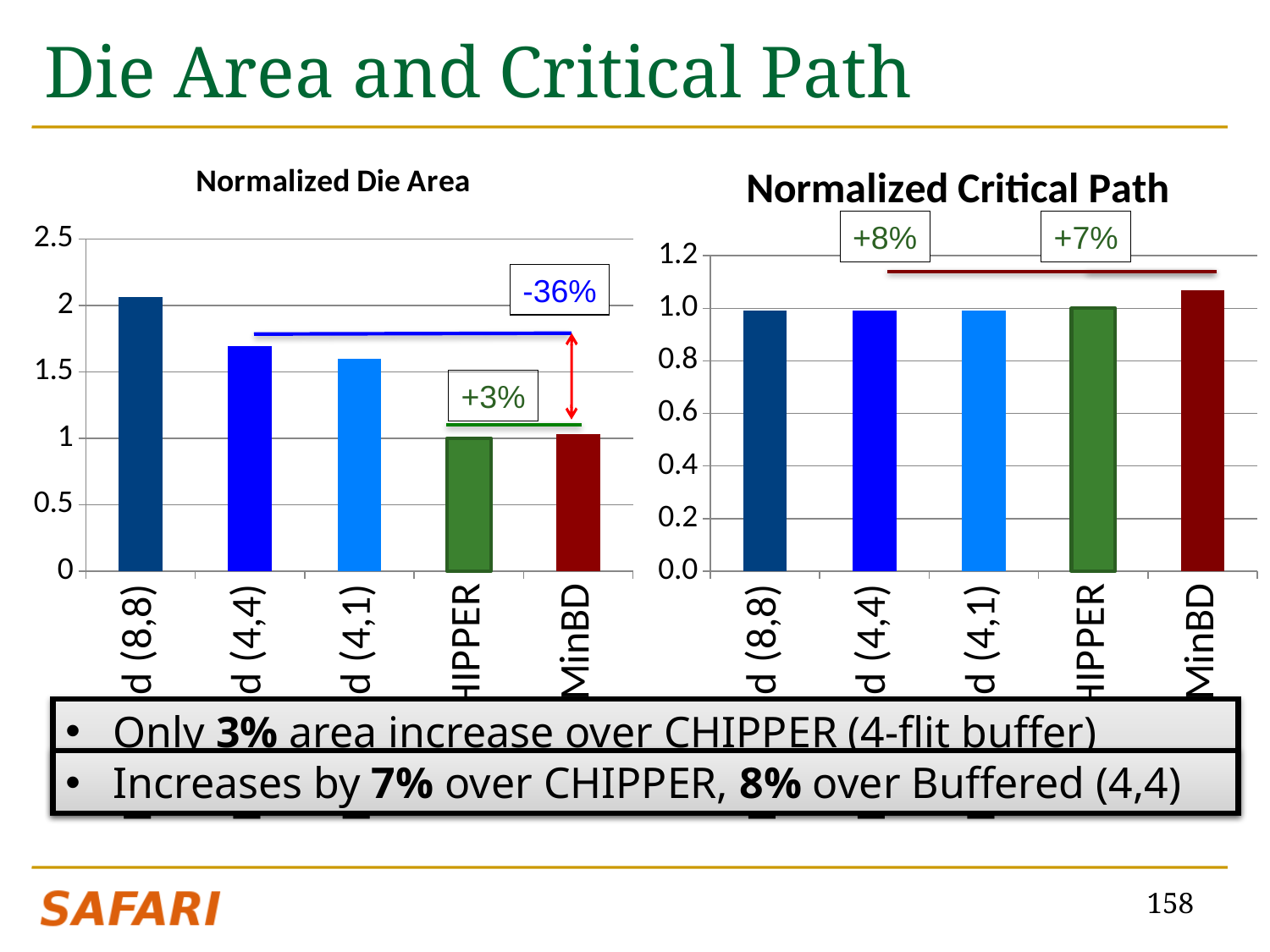
How many bars does the Normalized Critical Path chart show? 5 In the Normalized Critical Path chart, is the value for MinBD greater or less than 1.0? greater In the Normalized Critical Path chart, what percentage annotation is shown above the (4,4) bar? +8% In the Normalized Die Area chart, is the value for MinBD greater or less than 1.5? less In the Normalized Die Area chart, is the value for the (8,8) bar greater or less than 2? greater In the Normalized Die Area chart, which bar is the highest? Buffered (8,8) In the Normalized Critical Path chart, which is larger: MinBD or CHIPPER? MinBD What kind of chart is the Normalized Die Area chart? bar chart In the Normalized Critical Path chart, which bar is the highest? MinBD In the Normalized Die Area chart, which is larger: the (8,8) bar or the MinBD bar? (8,8) In the Normalized Die Area chart, what percentage change is annotated between MinBD and CHIPPER? +3%